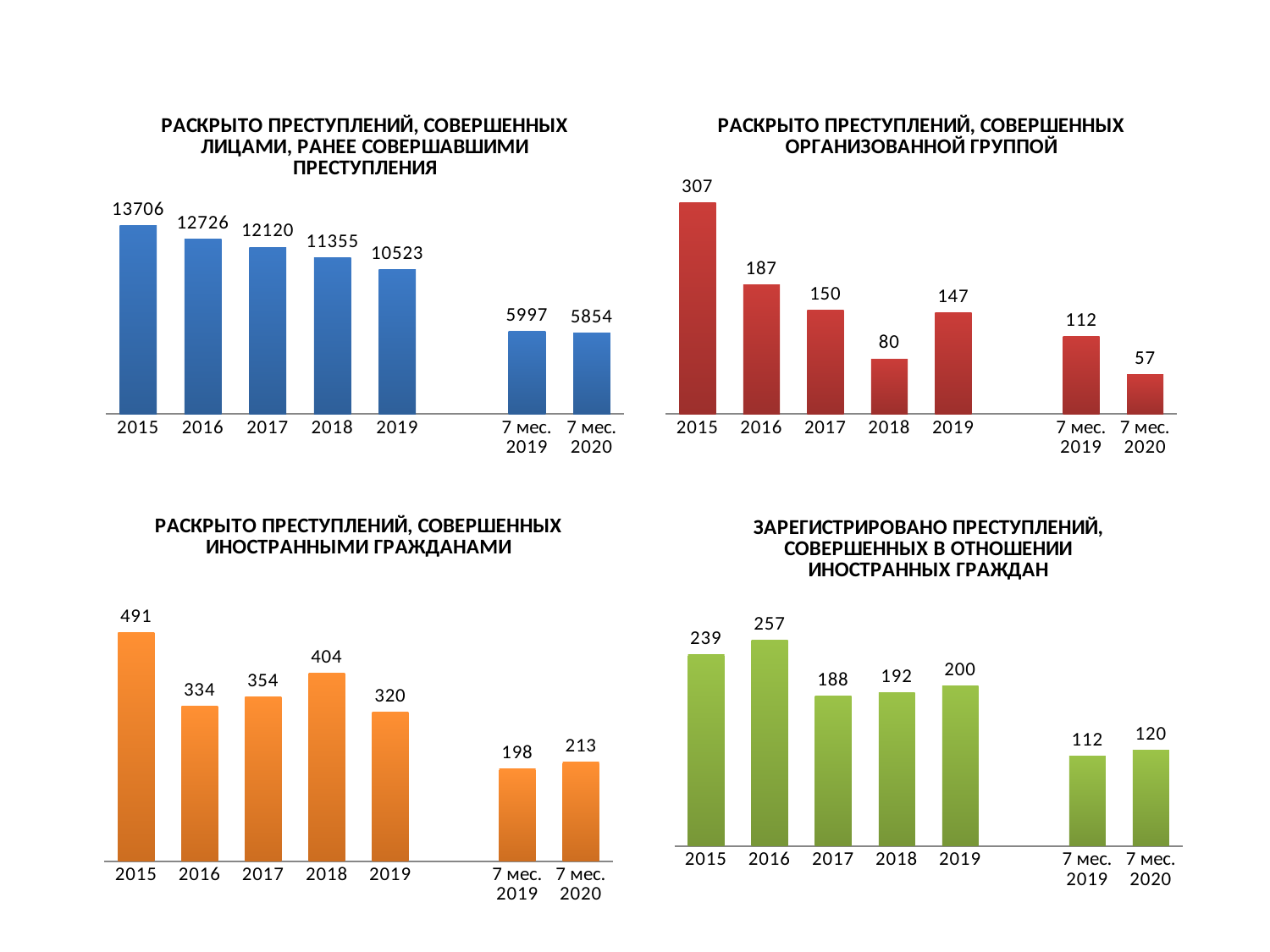
In the bottom-left chart (РАСКРЫТО ПРЕСТУПЛЕНИЙ, СОВЕРШЕННЫХ ИНОСТРАННЫМИ ГРАЖДАНАМИ), how many bars are plotted? 7 In the top-right chart (РАСКРЫТО ПРЕСТУПЛЕНИЙ, СОВЕРШЕННЫХ ОРГАНИЗОВАННОЙ ГРУППОЙ), which is larger, the value for 2017 or the value for 2019? 2017 What kind of chart is the bottom-right chart (ЗАРЕГИСТРИРОВАНО ПРЕСТУПЛЕНИЙ, СОВЕРШЕННЫХ В ОТНОШЕНИИ ИНОСТРАННЫХ ГРАЖДАН)? bar chart In the bottom-left chart (РАСКРЫТО ПРЕСТУПЛЕНИЙ, СОВЕРШЕННЫХ ИНОСТРАННЫМИ ГРАЖДАНАМИ), what is the value for 2018? 404 In the top-left chart (РАСКРЫТО ПРЕСТУПЛЕНИЙ, СОВЕРШЕННЫХ ЛИЦАМИ, РАНЕЕ СОВЕРШАВШИМИ ПРЕСТУПЛЕНИЯ), do the values rise or fall from 2015 to 2019? fall In the top-right chart (РАСКРЫТО ПРЕСТУПЛЕНИЙ, СОВЕРШЕННЫХ ОРГАНИЗОВАННОЙ ГРУППОЙ), which category has the lowest value? 7 мес. 2020 In the bottom-right chart (ЗАРЕГИСТРИРОВАНО ПРЕСТУПЛЕНИЙ, СОВЕРШЕННЫХ В ОТНОШЕНИИ ИНОСТРАННЫХ ГРАЖДАН), what is the value for 2016? 257 In the top-right chart (РАСКРЫТО ПРЕСТУПЛЕНИЙ, СОВЕРШЕННЫХ ОРГАНИЗОВАННОЙ ГРУППОЙ), what is the value for 2018? 80 In the top-left chart (РАСКРЫТО ПРЕСТУПЛЕНИЙ, СОВЕРШЕННЫХ ЛИЦАМИ, РАНЕЕ СОВЕРШАВШИМИ ПРЕСТУПЛЕНИЯ), what is the difference between the values for 7 мес. 2019 and 7 мес. 2020? 143 In the bottom-left chart (РАСКРЫТО ПРЕСТУПЛЕНИЙ, СОВЕРШЕННЫХ ИНОСТРАННЫМИ ГРАЖДАНАМИ), which category has the highest value? 2015 In the top-left chart (РАСКРЫТО ПРЕСТУПЛЕНИЙ, СОВЕРШЕННЫХ ЛИЦАМИ, РАНЕЕ СОВЕРШАВШИМИ ПРЕСТУПЛЕНИЯ), what is the value for 2015? 13706 In the bottom-right chart (ЗАРЕГИСТРИРОВАНО ПРЕСТУПЛЕНИЙ, СОВЕРШЕННЫХ В ОТНОШЕНИИ ИНОСТРАННЫХ ГРАЖДАН), what is the difference between the values for 2015 and 2016? 18